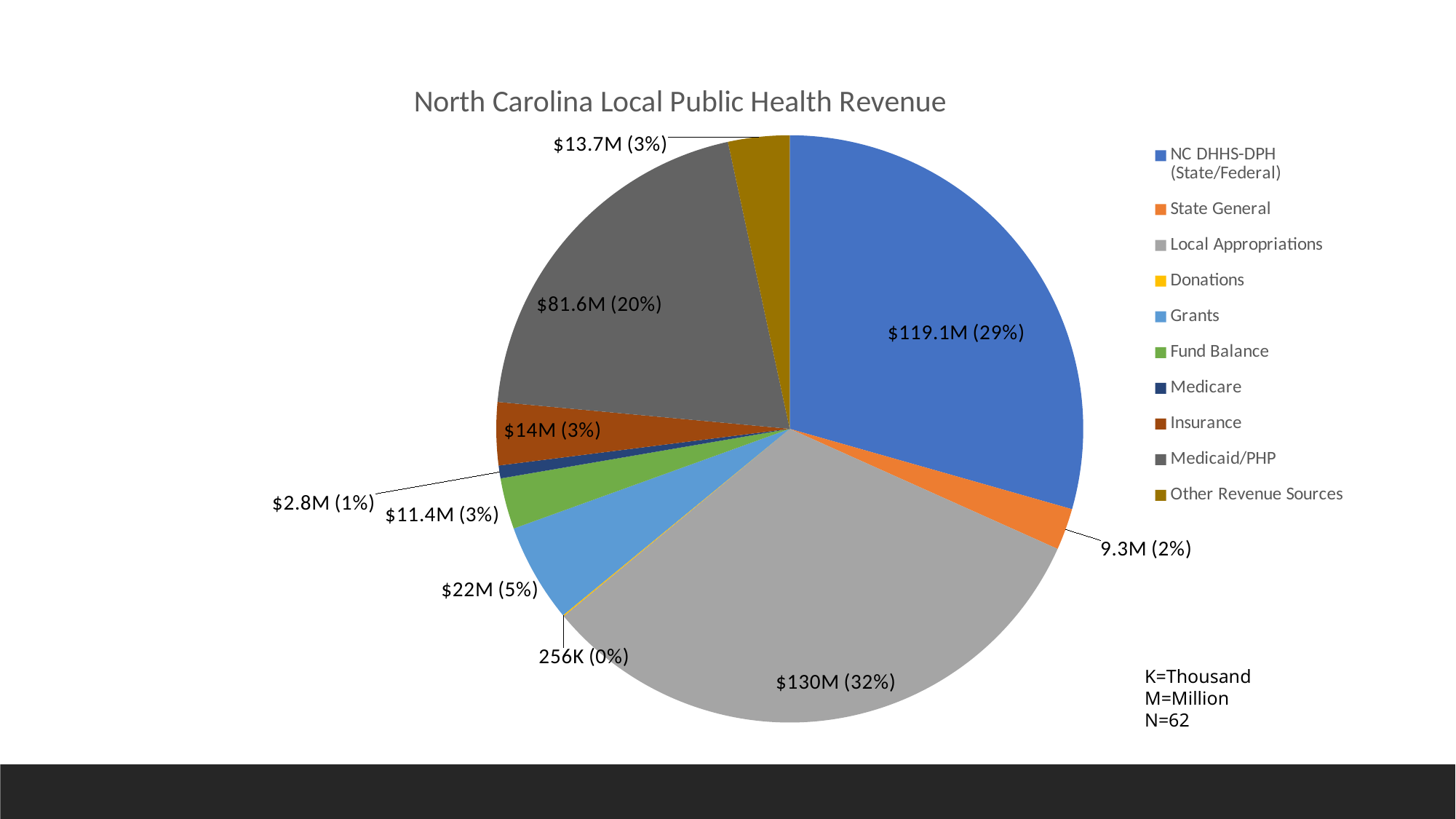
Which revenue source has the largest slice? Local Appropriations What share of the pie does NC DHHS-DPH (State/Federal) represent? 29% What is the title of the chart? North Carolina Local Public Health Revenue Which is larger, Insurance or Fund Balance? Insurance How many revenue sources does the legend list? 10 What is the value shown for Local Appropriations? $130M What is the value shown for Medicaid/PHP? $81.6M What kind of chart is shown on the slide? pie chart What share of the pie does Medicaid/PHP represent? 20% Which revenue source has the smallest slice? Donations What is the value shown for Grants? $22M What is the difference in percentage share between Local Appropriations and NC DHHS-DPH (State/Federal)? 3%